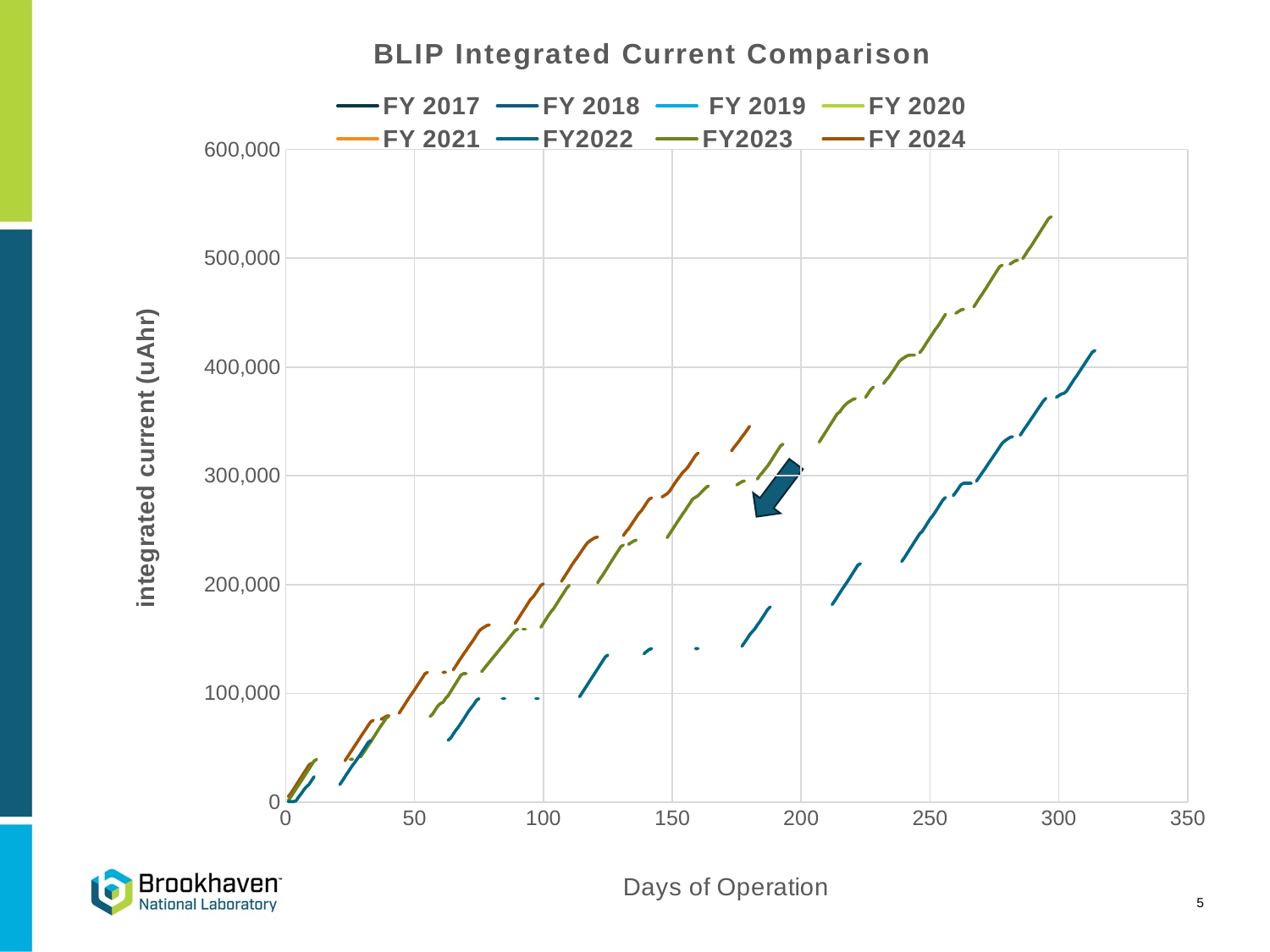
What is the label of the y axis? integrated current (uAhr) How many series does the legend list? 8 Which series extends to the most days of operation on the chart? FY2022 Is the highest value reached by the FY 2024 line greater or less than 300,000? greater Is the highest value reached by the FY2023 line greater or less than 500,000? greater Does the integrated current for each plotted series rise or fall as days of operation increase? rise What kind of chart is shown on the slide? line chart Is the value of the FY2022 line at 200 days of operation greater or less than 200,000? less Which series reaches the highest integrated current on the chart? FY2023 At 250 days of operation, which line is higher: FY2023 or FY2022? FY2023 What is the title of the chart? BLIP Integrated Current Comparison